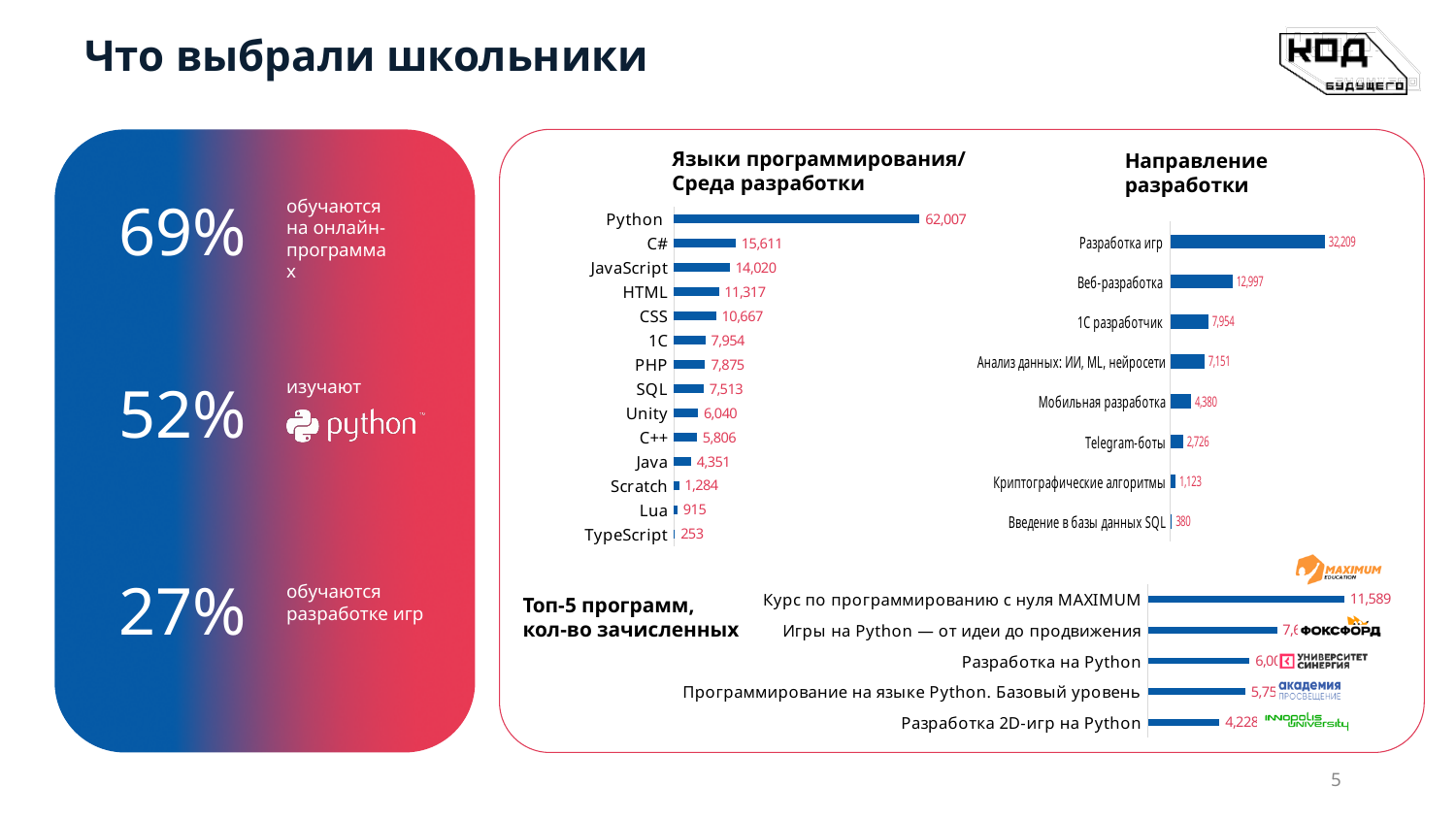
In the chart "Топ-5 программ, кол-во зачисленных", what is the value for Разработка 2D-игр на Python? 4,228 In the chart "Направление разработки", what is the difference between the values for Разработка игр and Веб-разработка? 19,212 What type of chart is "Направление разработки"? Bar chart In the chart "Направление разработки", what is the value for Веб-разработка? 12,997 In the chart "Направление разработки", how many categories are plotted? 8 In the chart "Языки программирования/Среда разработки", which is larger, the value for Unity or the value for Java? Unity In the chart "Языки программирования/Среда разработки", what is the difference between the values for C# and JavaScript? 1,591 In the chart "Языки программирования/Среда разработки", how many categories are plotted? 14 In the chart "Языки программирования/Среда разработки", which category has the lowest value? TypeScript In the chart "Направление разработки", which category has the highest value? Разработка игр In the chart "Топ-5 программ, кол-во зачисленных", what is the value for Курс по программированию с нуля MAXIMUM? 11,589 In the chart "Языки программирования/Среда разработки", what is the value for Python? 62,007